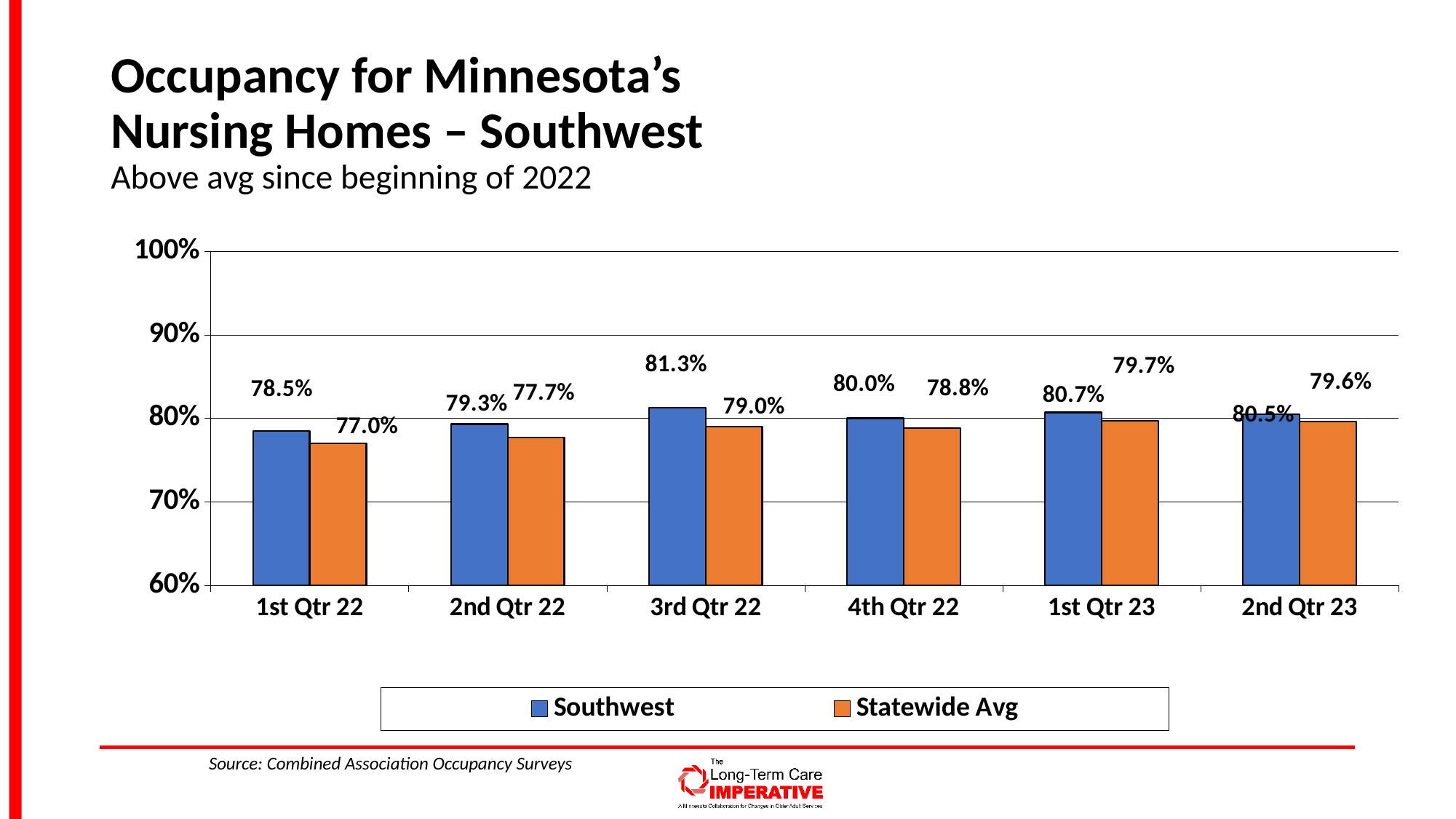
Which is larger in 4th Qtr 22, the Southwest value or the Statewide Avg value? Southwest What is the Southwest occupancy value for 1st Qtr 23? 80.7% In which quarter is the Statewide Avg occupancy lowest? 1st Qtr 22 In which quarter is the Southwest occupancy lowest? 1st Qtr 22 What is the Southwest occupancy value for 3rd Qtr 22? 81.3% How many series does the legend list? 2 In which quarter is the Southwest occupancy highest? 3rd Qtr 22 What is the Statewide Avg occupancy value for 1st Qtr 22? 77.0% What is the difference between the Southwest and Statewide Avg values in 3rd Qtr 22? 2.3 percentage points How many quarters are shown on the x axis? 6 What is the Statewide Avg occupancy value for 2nd Qtr 23? 79.6% What kind of chart is shown on the slide? Bar chart